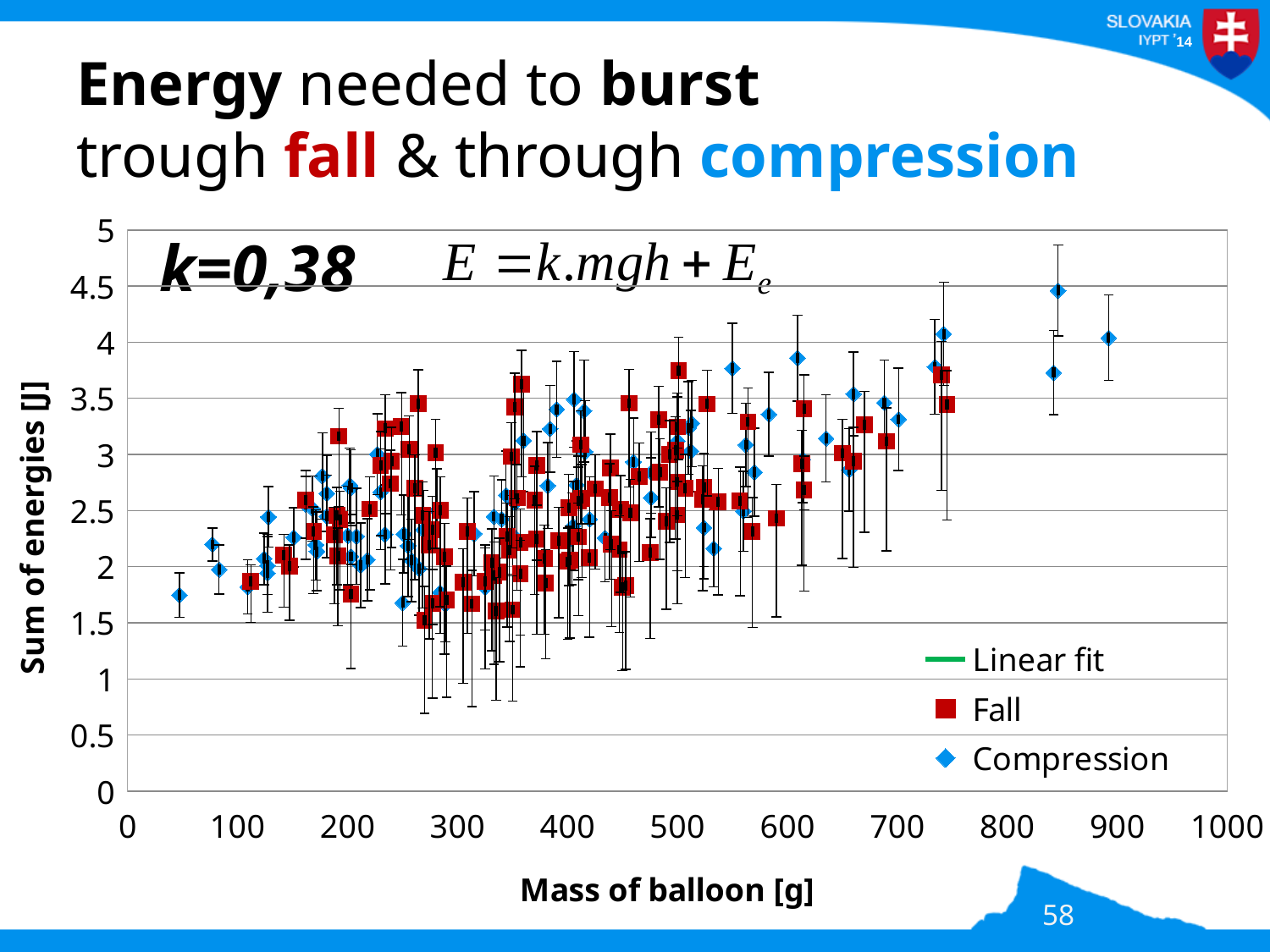
Is the value for the leftmost Compression point (near 50 g) greater or less than 2? less How many series does the chart legend list? 3 What kind of chart is shown on the slide? scatter chart What is the label of the horizontal axis of the chart? Mass of balloon [g] What is the highest tick value shown on the vertical axis? 5 Is the value for the rightmost Compression point (near 890 g) greater or less than 3.5? greater What are the entries listed in the chart legend? Linear fit, Fall, Compression Overall, do the plotted energy values rise or fall as the mass of the balloon increases? rise